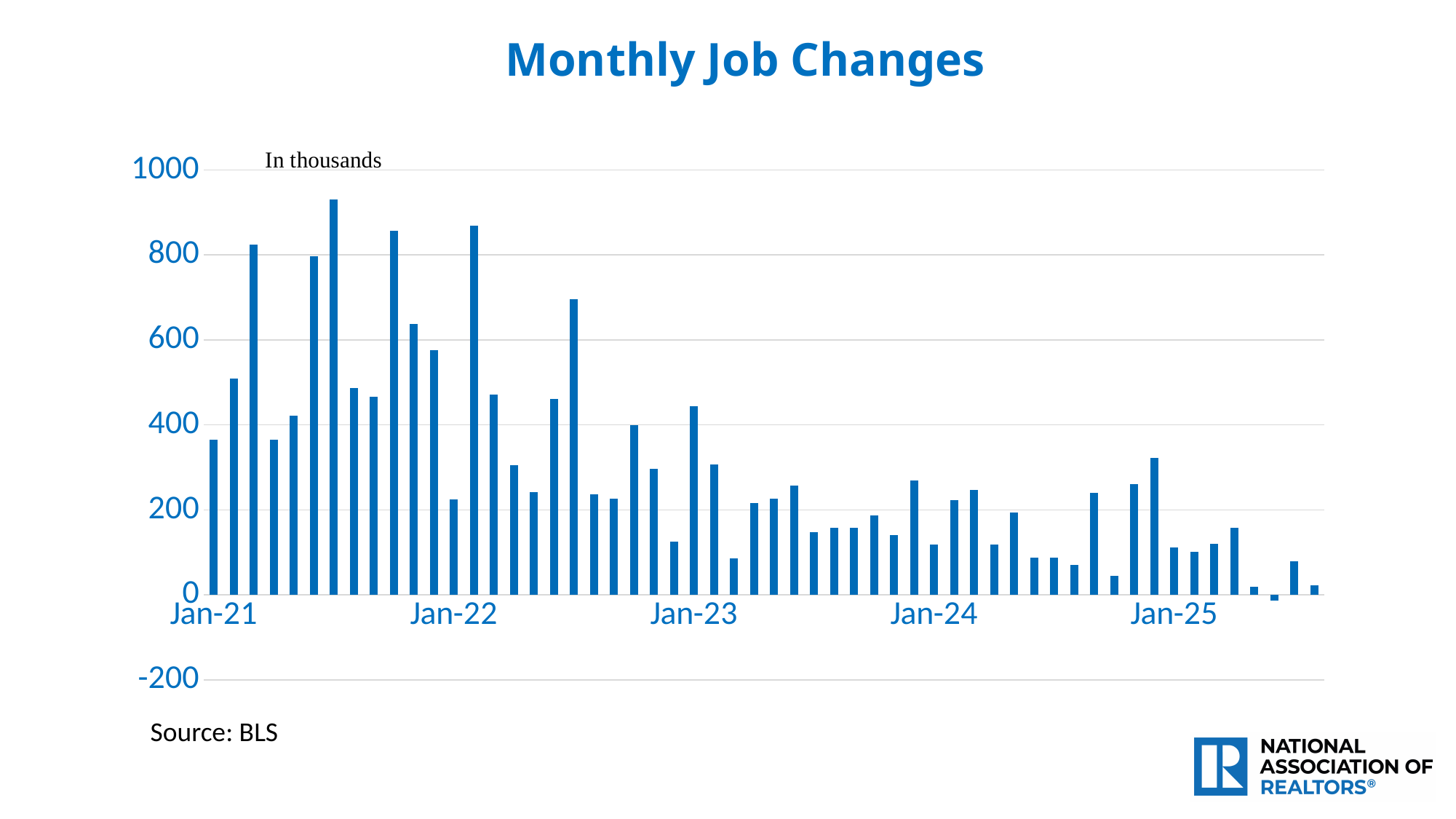
How many bars on the chart fall below 0? 1 What is the title of the chart? Monthly Job Changes Overall, do the monthly job changes rise or fall from Jan-21 to Jan-25? fall What kind of chart is shown on the slide? Bar chart Is the value for Jan-24 greater or less than 200? less Is the value for Jan-25 greater or less than 200? less Which is larger, the value for Jan-21 or the value for Jan-24? Jan-21 Is the highest bar on the chart greater or less than 800? greater In what units are the values on the chart expressed? In thousands